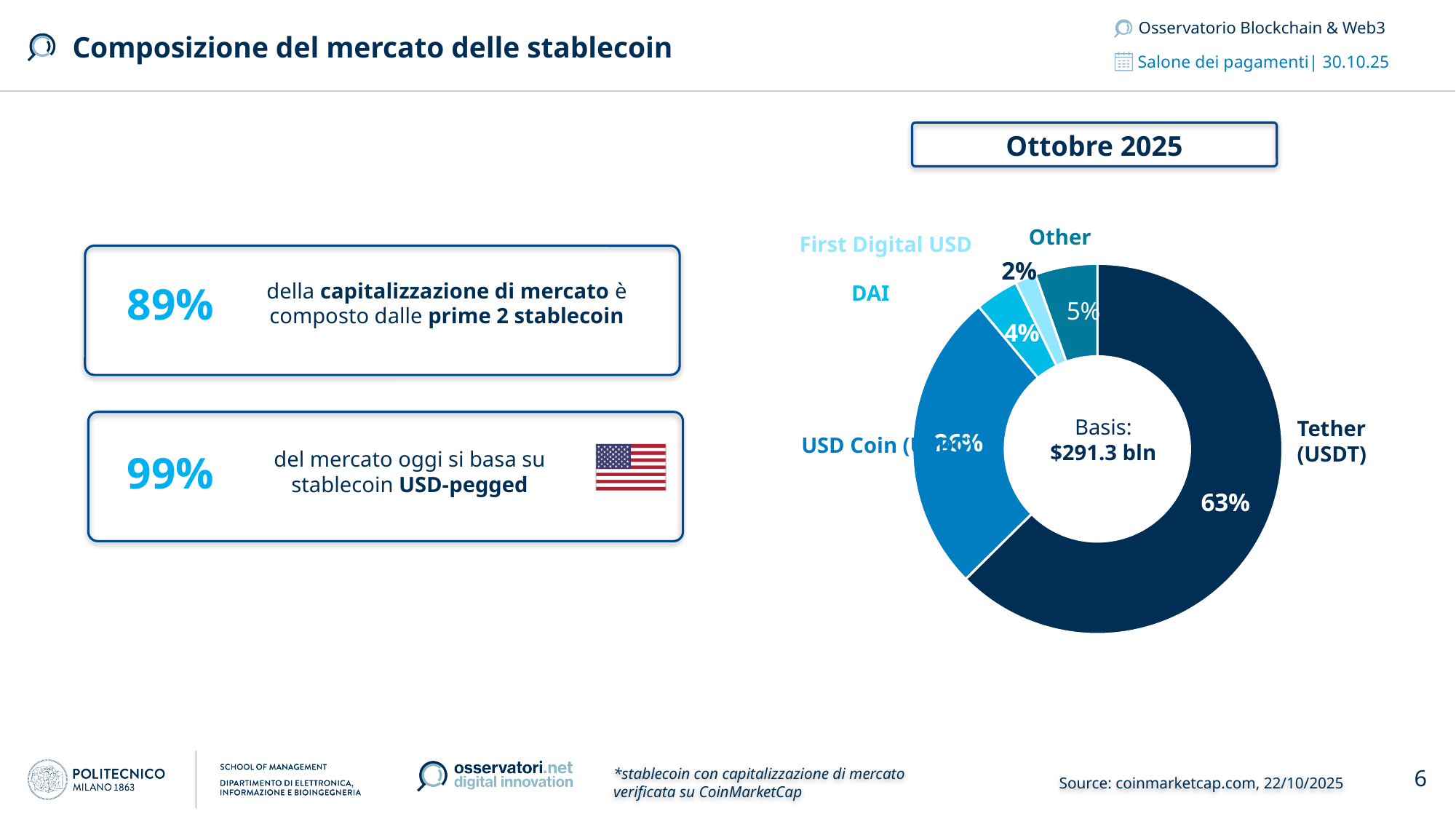
Which slice is larger in the donut chart, DAI or Other? Other What is the basis (total market capitalization) shown in the centre of the donut chart? $291.3 bln What share does First Digital USD hold in the donut chart? 2% What share does the 'Other' slice represent in the donut chart? 5% Which named slice is the smallest in the donut chart? First Digital USD How many percentage points larger is Tether (USDT)'s share than the 'Other' share? 58 percentage points How many slices does the donut chart have? 5 What type of chart is used to show the stablecoin market composition? Pie (donut) chart How many percentage points larger is DAI's share than First Digital USD's share? 2 percentage points What share of the stablecoin market does Tether (USDT) hold in the donut chart? 63% What share does DAI hold in the donut chart? 4% Which stablecoin has the largest slice in the donut chart? Tether (USDT)